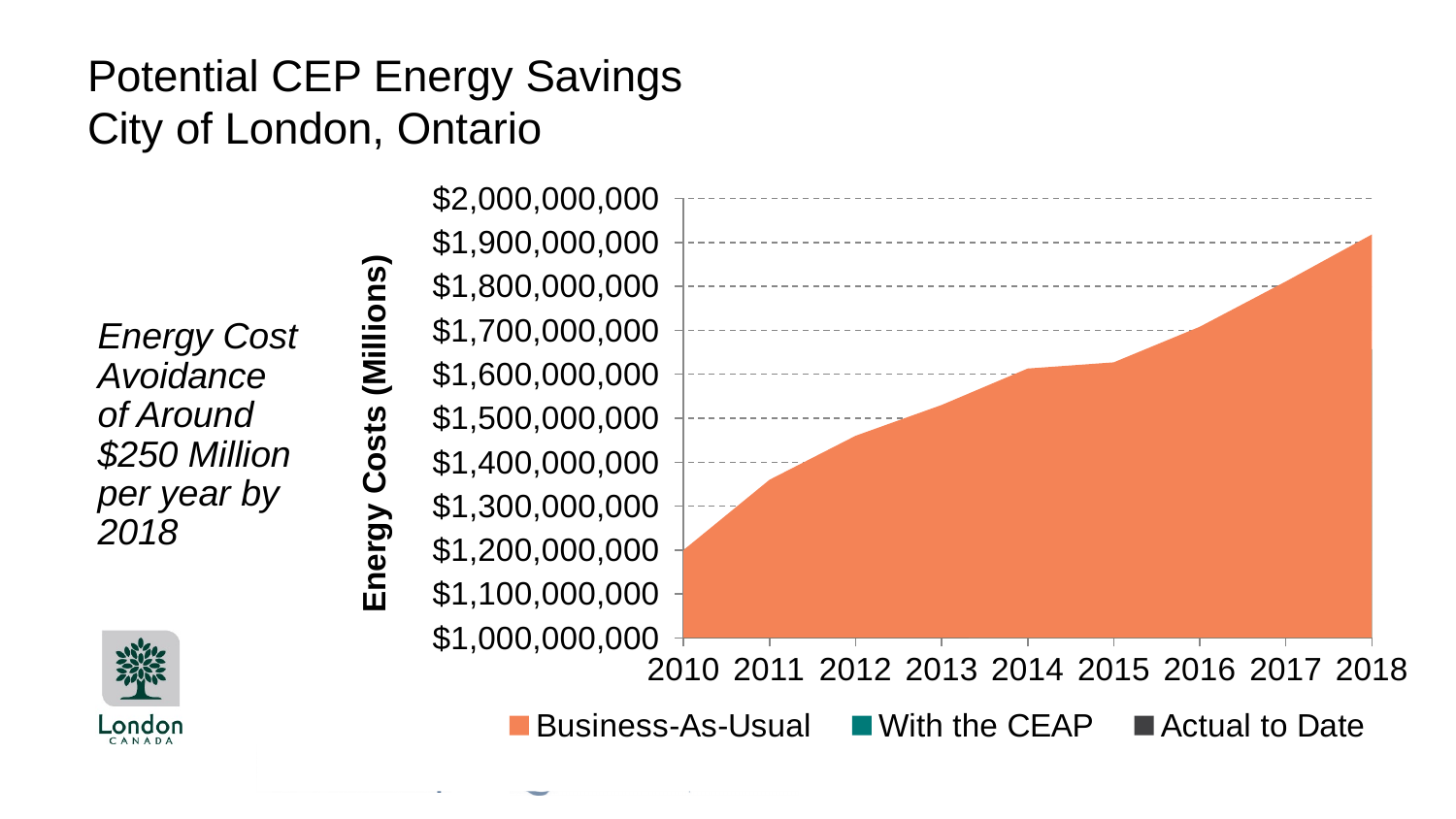
How many series does the legend list? 3 In which year is the Business-As-Usual energy cost lowest? 2010 What kind of chart is shown on the slide? area chart Is the Business-As-Usual value for 2018 greater or less than $1,800,000,000? greater Is the Business-As-Usual value for 2014 greater or less than $1,500,000,000? greater Which is larger, the Business-As-Usual value for 2016 or for 2012? 2016 Do the Business-As-Usual energy costs rise or fall from 2010 to 2018? rise Is the Business-As-Usual value for 2015 greater or less than $1,700,000,000? less What is the label on the y axis of the chart? Energy Costs (Millions) In which year is the Business-As-Usual energy cost highest? 2018 How many years are shown along the x axis? 9